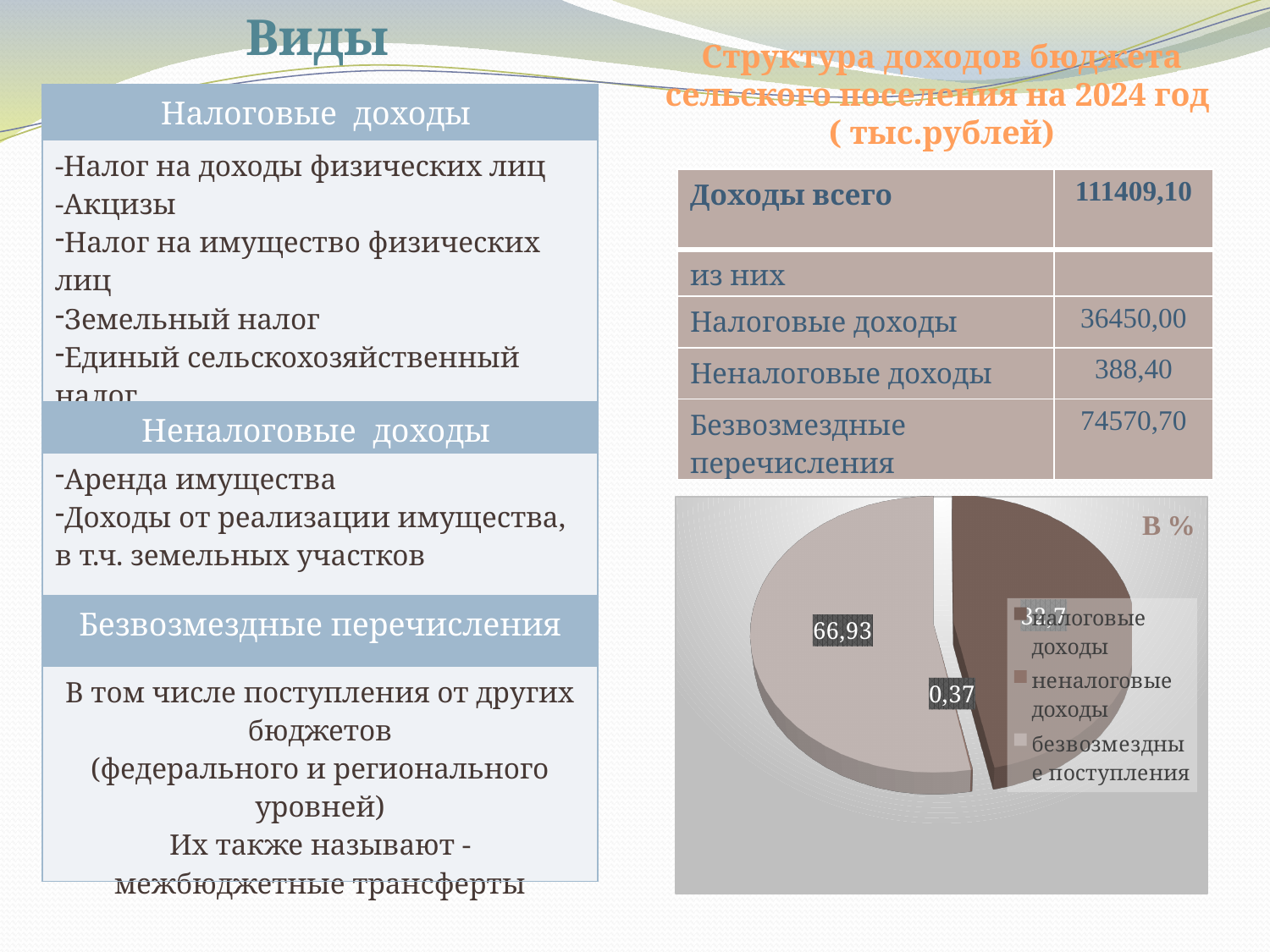
What share of the pie chart does безвозмездные поступления take? 66,93 What is the title shown on the pie chart? В % How many slices does the pie chart have? 3 In the pie chart, which is larger: безвозмездные поступления or налоговые доходы? безвозмездные поступления What kind of chart is shown on the right side of the slide? pie chart What is the difference between the values for безвозмездные поступления and неналоговые доходы in the pie chart? 66,56 What is the value shown for неналоговые доходы in the pie chart? 0,37 What is the value shown for безвозмездные поступления in the pie chart? 66,93 How many entries does the legend of the pie chart list? 3 In the pie chart, which is larger: налоговые доходы or неналоговые доходы? налоговые доходы Which category has the largest slice in the pie chart? безвозмездные поступления Which category has the smallest slice in the pie chart? неналоговые доходы